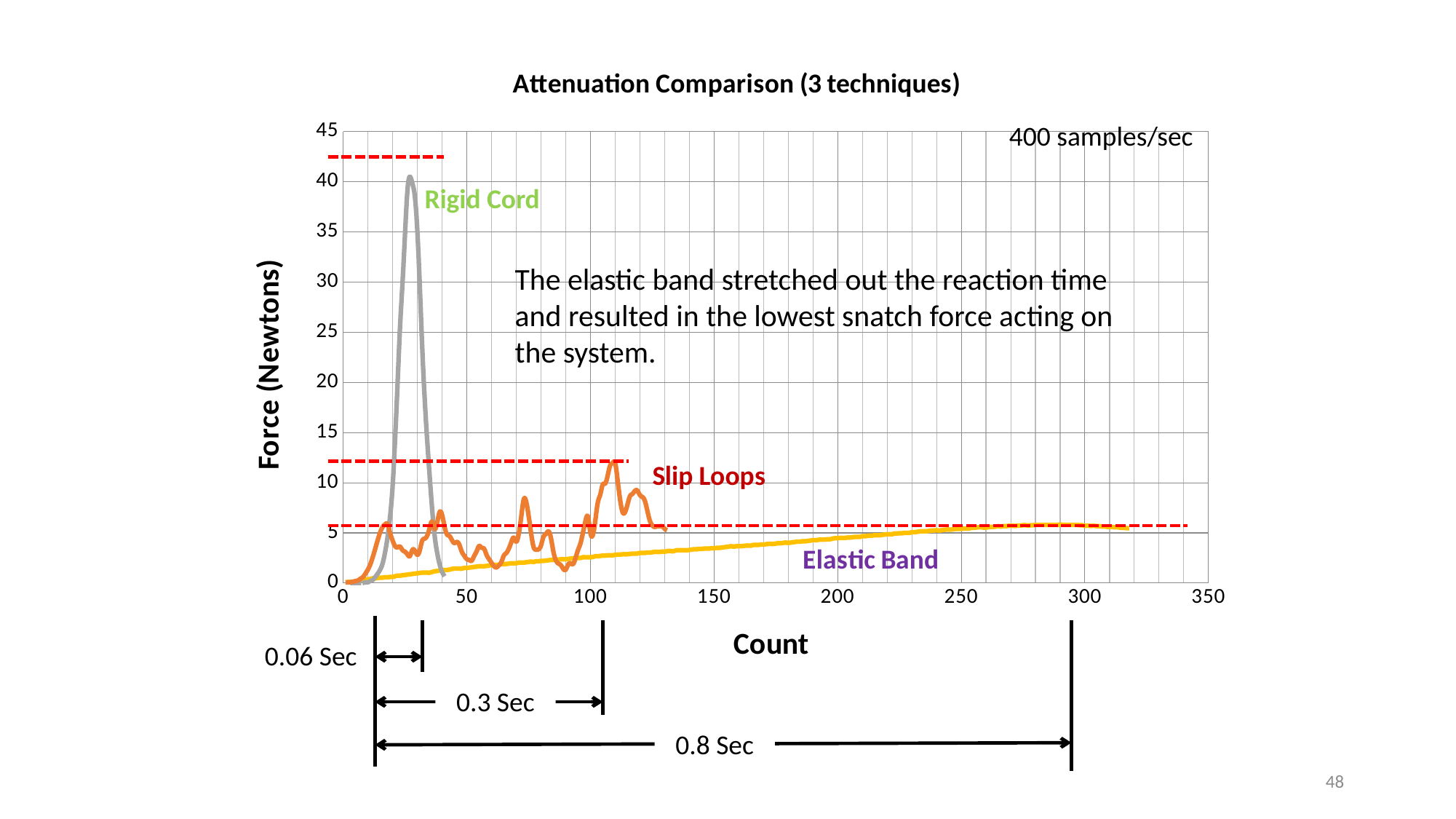
What is the highest value shown on the x axis (Count)? 350 Which series has the lowest peak force? Elastic Band Which series has a higher peak force, Slip Loops or Elastic Band? Slip Loops How many techniques (series) are plotted on the chart? 3 What kind of chart is shown on the slide? line chart Is the peak force for Elastic Band greater or less than 10 Newtons? less What is the title of the chart? Attenuation Comparison (3 techniques) Is the peak force for Rigid Cord greater or less than 35 Newtons? greater Which series has a higher peak force, Rigid Cord or Slip Loops? Rigid Cord Is the peak force for Slip Loops greater or less than 15 Newtons? less What is the sampling rate noted on the chart? 400 samples/sec Which series reaches the highest peak force? Rigid Cord